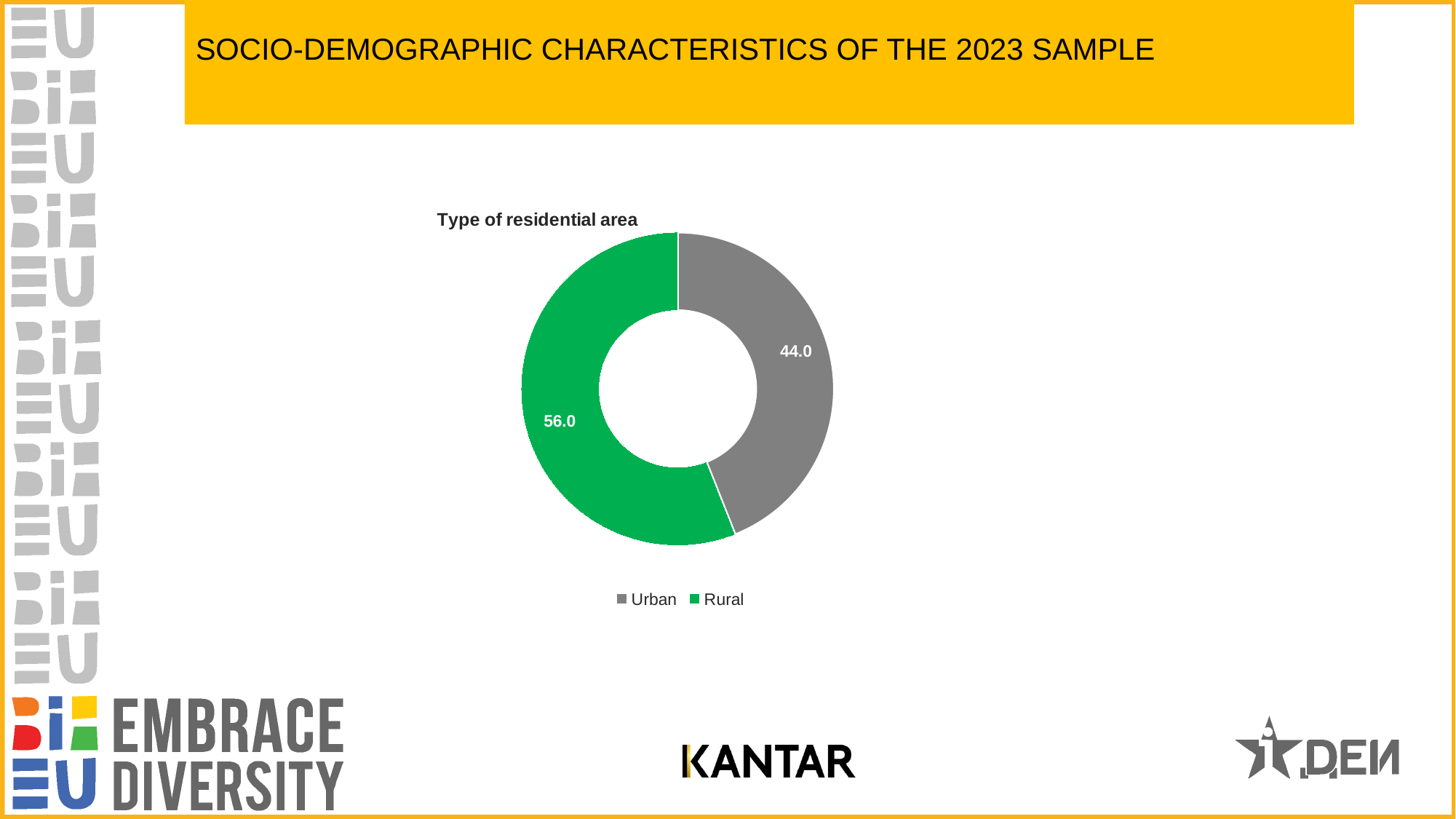
What is the value for Urban in the Type of residential area chart? 44.0 Which category has the smallest share in the Type of residential area chart? Urban How many entries does the legend of the Type of residential area chart list? 2 What is the total of the Urban and Rural values in the Type of residential area chart? 100.0 What is the difference between the Rural and Urban values in the Type of residential area chart? 12.0 How many categories are shown in the Type of residential area chart? 2 Which category has the largest share in the Type of residential area chart? Rural What colour represents Rural in the Type of residential area chart? Green Which is larger in the Type of residential area chart, Urban or Rural? Rural What kind of chart is used to show Type of residential area? Doughnut (pie) chart What is the value for Rural in the Type of residential area chart? 56.0 What is the title of the chart on the slide? Type of residential area